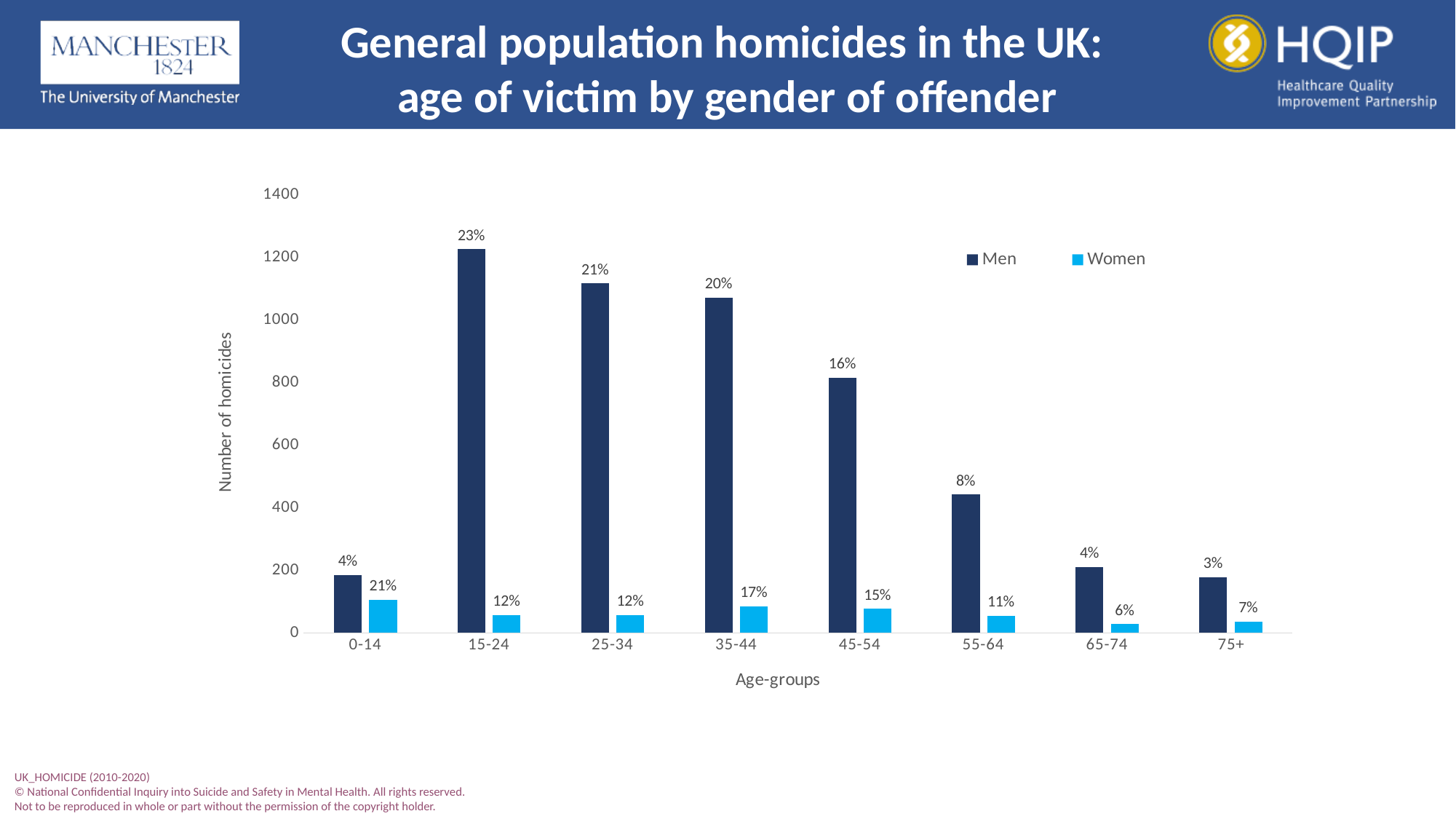
What kind of chart is shown on the slide? Bar chart How many series does the legend list? 2 What percentage label is shown on the Men bar for the 15-24 age-group? 23% How many age-groups are shown on the x axis? 8 From the 15-24 age-group to the 75+ age-group, do the Men bars rise or fall? Fall What percentage label is shown on the Women bar for the 0-14 age-group? 21% Is the number of homicides for Women in the 0-14 age-group greater or less than 200? less What is the difference between the Men percentage labels for 15-24 and 25-34? 2 percentage points Is the number of homicides for Men in the 35-44 age-group greater or less than 1000? greater Which is larger, the Women percentage label for 35-44 or for 45-54? 35-44 Which age-group has the lowest percentage label for Men? 75+ Which age-group has the tallest Men bar? 15-24